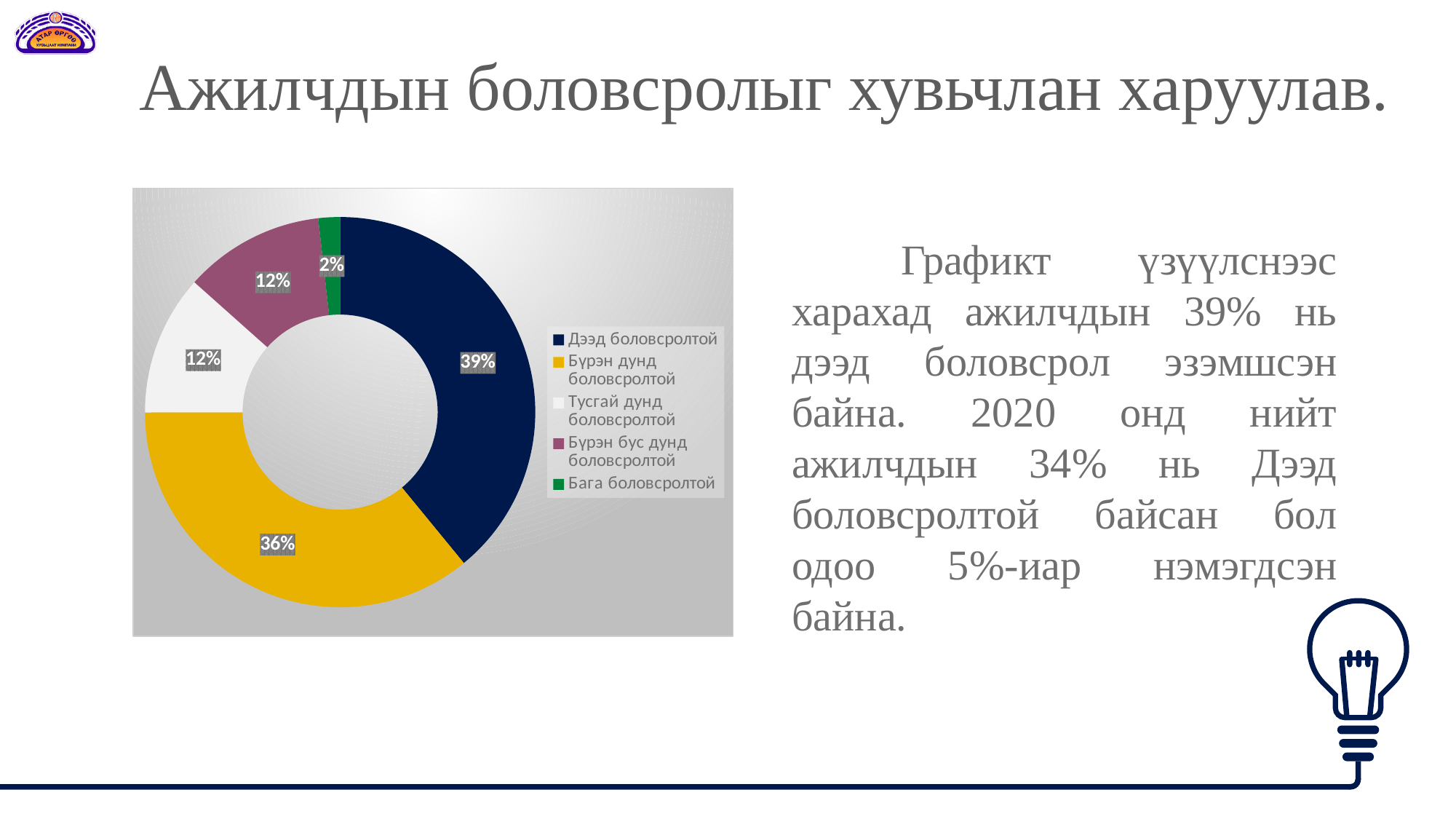
What percentage of employees are Бүрэн дунд боловсролтой? 36% What percentage of employees are Дээд боловсролтой? 39% What kind of chart is shown on the slide? Doughnut (pie) chart Which category has the smallest share of the chart? Бага боловсролтой How many categories does the legend list? 5 What colour represents Бүрэн дунд боловсролтой in the chart? Yellow Which category has the largest share of the chart? Дээд боловсролтой Which is larger: the share for Бүрэн дунд боловсролтой or the share for Бүрэн бус дунд боловсролтой? Бүрэн дунд боловсролтой What percentage of employees are Бага боловсролтой? 2% What is the difference in percentage points between Дээд боловсролтой and Бүрэн дунд боловсролтой? 3 percentage points What colour represents Бага боловсролтой in the chart? Green What percentage of employees are Тусгай дунд боловсролтой? 12%